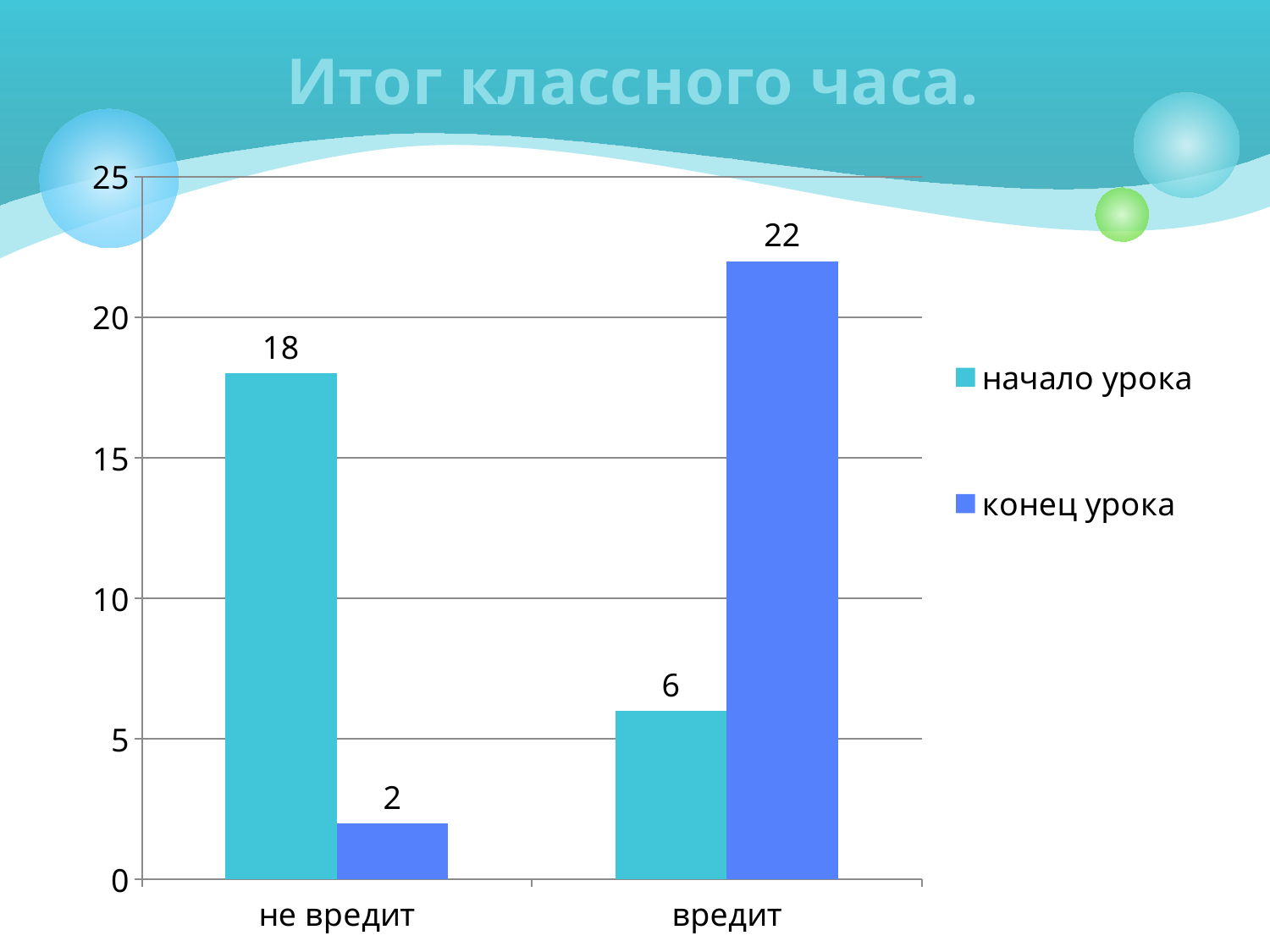
Which is larger for "вредит": the "начало урока" value or the "конец урока" value? конец урока Which category has the highest value in the "конец урока" series? вредит What is the difference between the "начало урока" and "конец урока" values for "не вредит"? 16 What is the value for "вредит" in the "конец урока" series? 22 How many categories are shown on the x axis? 2 What is the value for "не вредит" in the "конец урока" series? 2 How many series does the legend list? 2 What is the value for "не вредит" in the "начало урока" series? 18 What is the title of the slide? Итог классного часа. What is the value for "вредит" in the "начало урока" series? 6 Which category has the lowest value in the "начало урока" series? вредит What kind of chart is shown on the slide? bar chart